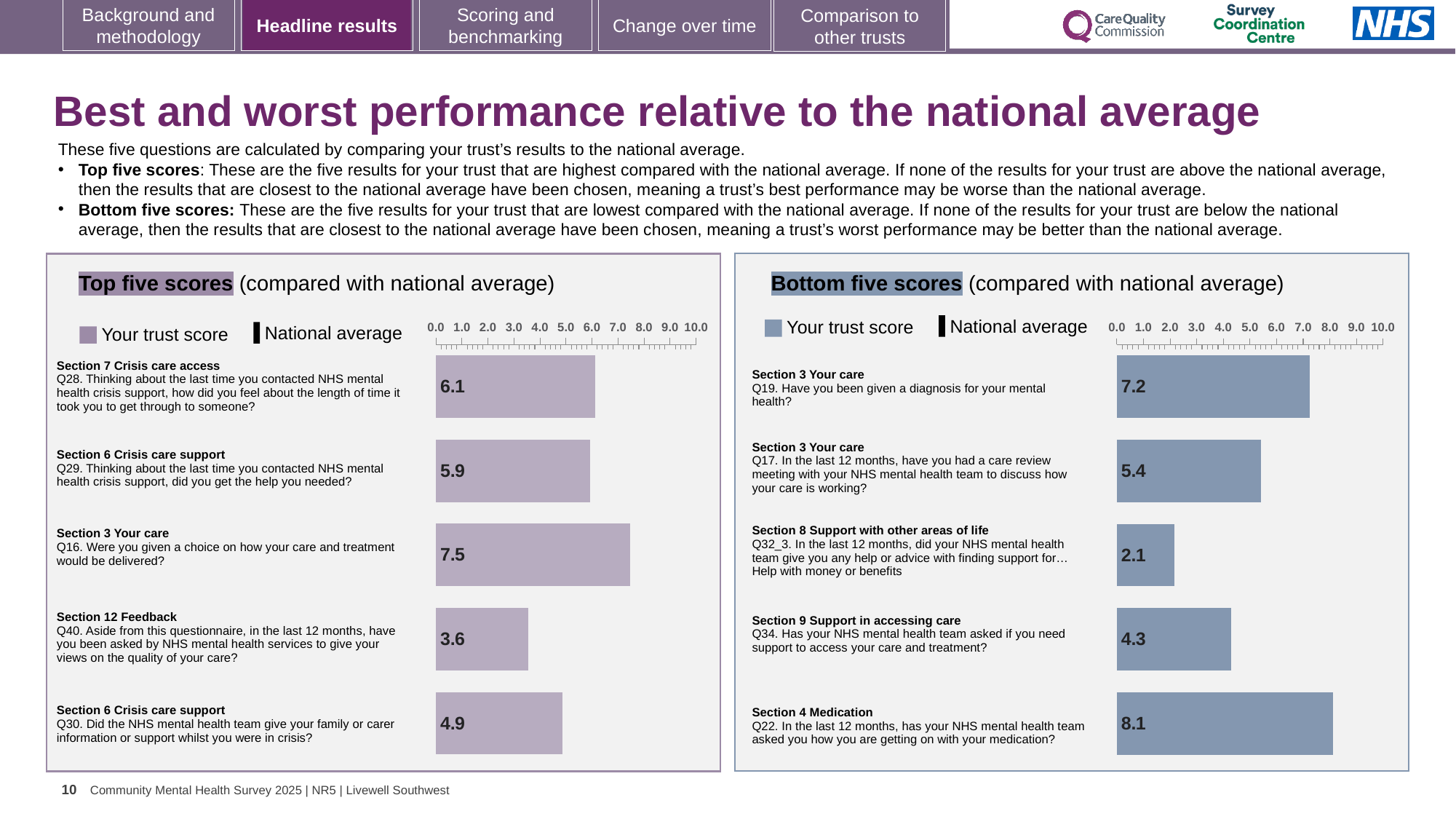
In the Bottom five scores chart, which has the larger trust score, Q34 or Q17? Q17 In the Bottom five scores chart, which question has the lowest trust score? Q32_3 How many series does the legend of the Top five scores chart list? 2 What kind of chart is the Bottom five scores chart? Bar chart In the Top five scores chart, which question has the highest trust score? Q16 In the Bottom five scores chart, what is the trust score for Q32_3 (help with money or benefits)? 2.1 In the Top five scores chart, what is the trust score for Q16 (Were you given a choice on how your care and treatment would be delivered)? 7.5 In the Top five scores chart, what is the trust score for Q40 (Aside from this questionnaire, have you been asked to give your views on the quality of your care)? 3.6 How many questions are plotted in the Top five scores chart? 5 In the Bottom five scores chart, what is the difference between the trust scores for Q19 and Q17? 1.8 In the Bottom five scores chart, what is the trust score for Q22 (has your NHS mental health team asked you how you are getting on with your medication)? 8.1 In the Top five scores chart, what is the difference between the trust scores for Q28 and Q29? 0.2